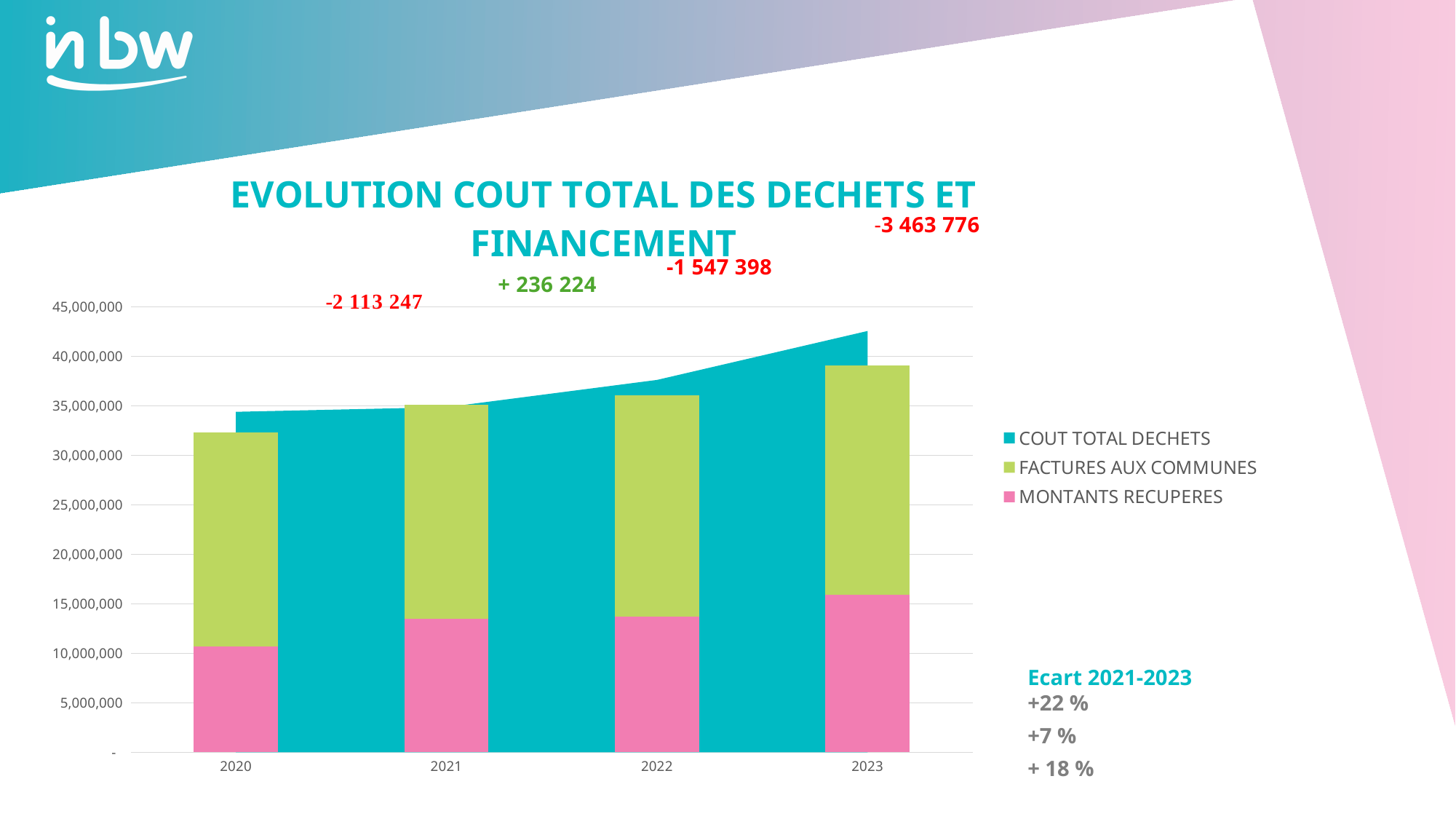
Which year has the tallest stacked bar? 2023 How many series does the legend list? 3 Does the COUT TOTAL DECHETS series rise or fall from 2020 to 2023? rises Which year has the shortest stacked bar? 2020 Is the total of the stacked bar for 2023 greater or less than 35,000,000? greater How many years are shown on the x axis? 4 Which year has the larger value for MONTANTS RECUPERES, 2020 or 2023? 2023 What kind of chart is used for the FACTURES AUX COMMUNES and MONTANTS RECUPERES series? bar chart Is the value for MONTANTS RECUPERES in 2020 greater or less than 15,000,000? less What is the title of the chart? EVOLUTION COUT TOTAL DES DECHETS ET FINANCEMENT Is the value for COUT TOTAL DECHETS in 2023 greater or less than 40,000,000? greater